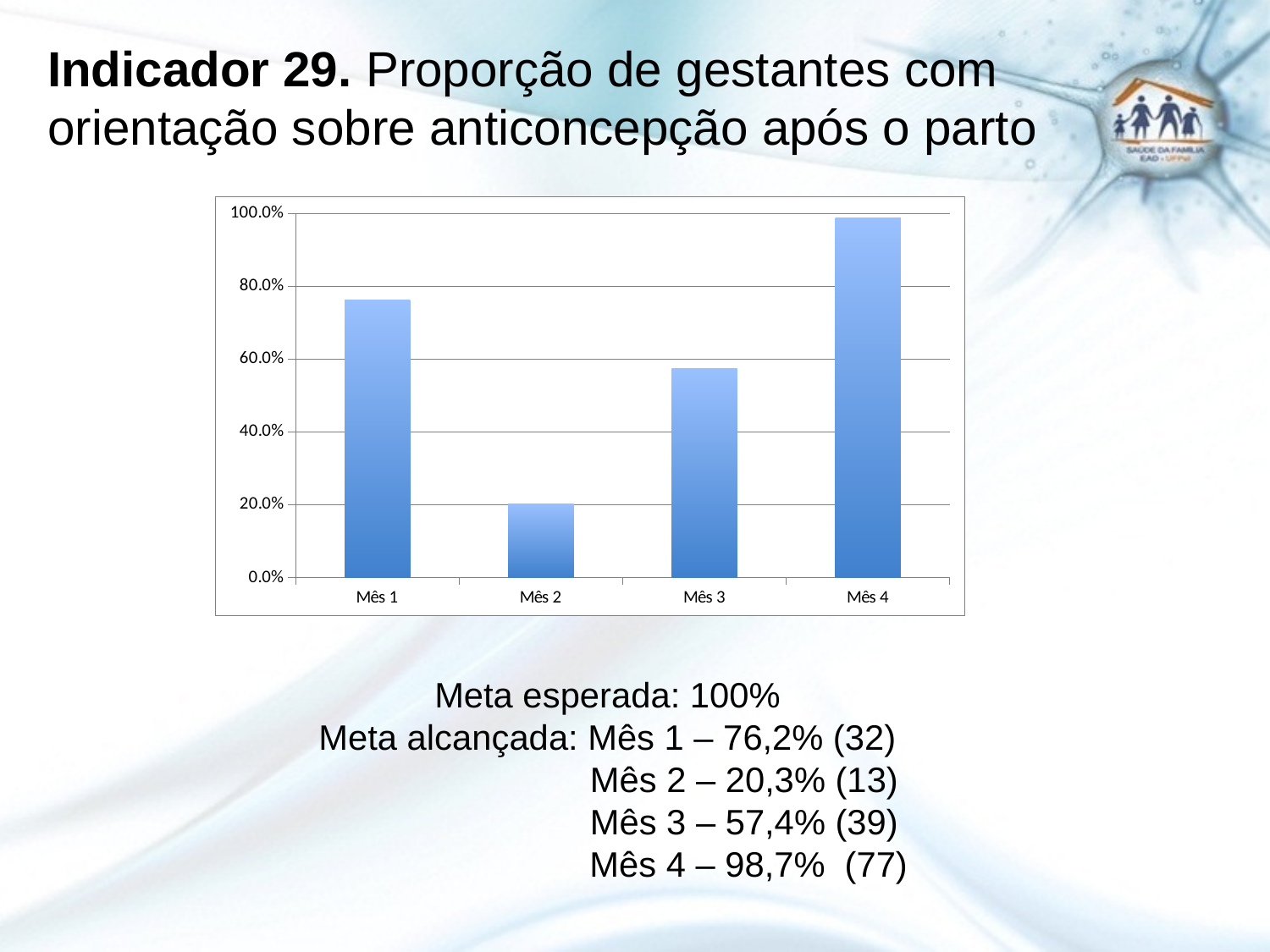
Which month has the highest bar on the chart? Mês 4 Is the value for Mês 3 greater or less than 80.0%? less According to the slide, what proportion was reached in Mês 2? 20,3% What is the difference between the proportions for Mês 4 and Mês 2 as stated on the slide? 78,4% What kind of chart is shown on the slide? bar chart Is the value for Mês 1 greater or less than 60.0%? greater How many categories (months) are plotted on the chart? 4 Which month has the lowest bar on the chart? Mês 2 Which is larger, the value for Mês 1 or the value for Mês 3? Mês 1 Is the value for Mês 2 greater or less than 40.0%? less According to the slide, what proportion was reached in Mês 4? 98,7% What is the expected target (meta esperada) stated on the slide? 100%